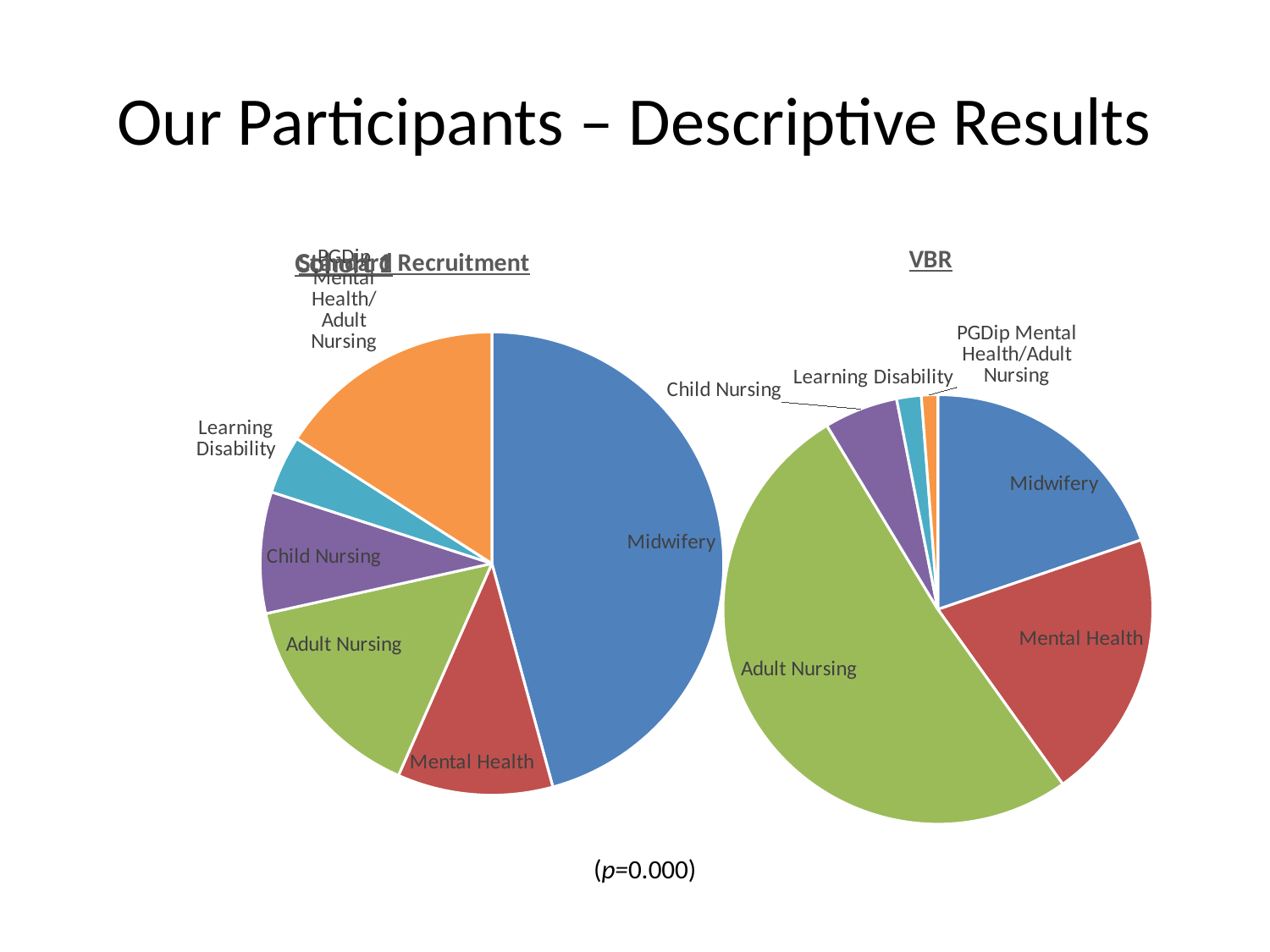
What is the title of the pie chart on the right of the slide? VBR In the VBR pie chart, which slice is larger, Child Nursing or Learning Disability? Child Nursing How many slices does the left pie chart have? 6 In the left pie chart, which slice is larger, Adult Nursing or Mental Health? Adult Nursing What colour is the Adult Nursing slice in the VBR pie chart? green In the left pie chart, which category has the smallest slice? Learning Disability How many slices does the VBR pie chart have? 6 What kind of chart is the left chart on the slide? pie chart In the VBR pie chart, which category has the largest slice? Adult Nursing What kind of chart is the chart titled VBR on the right of the slide? pie chart In the left pie chart, which category has the largest slice? Midwifery